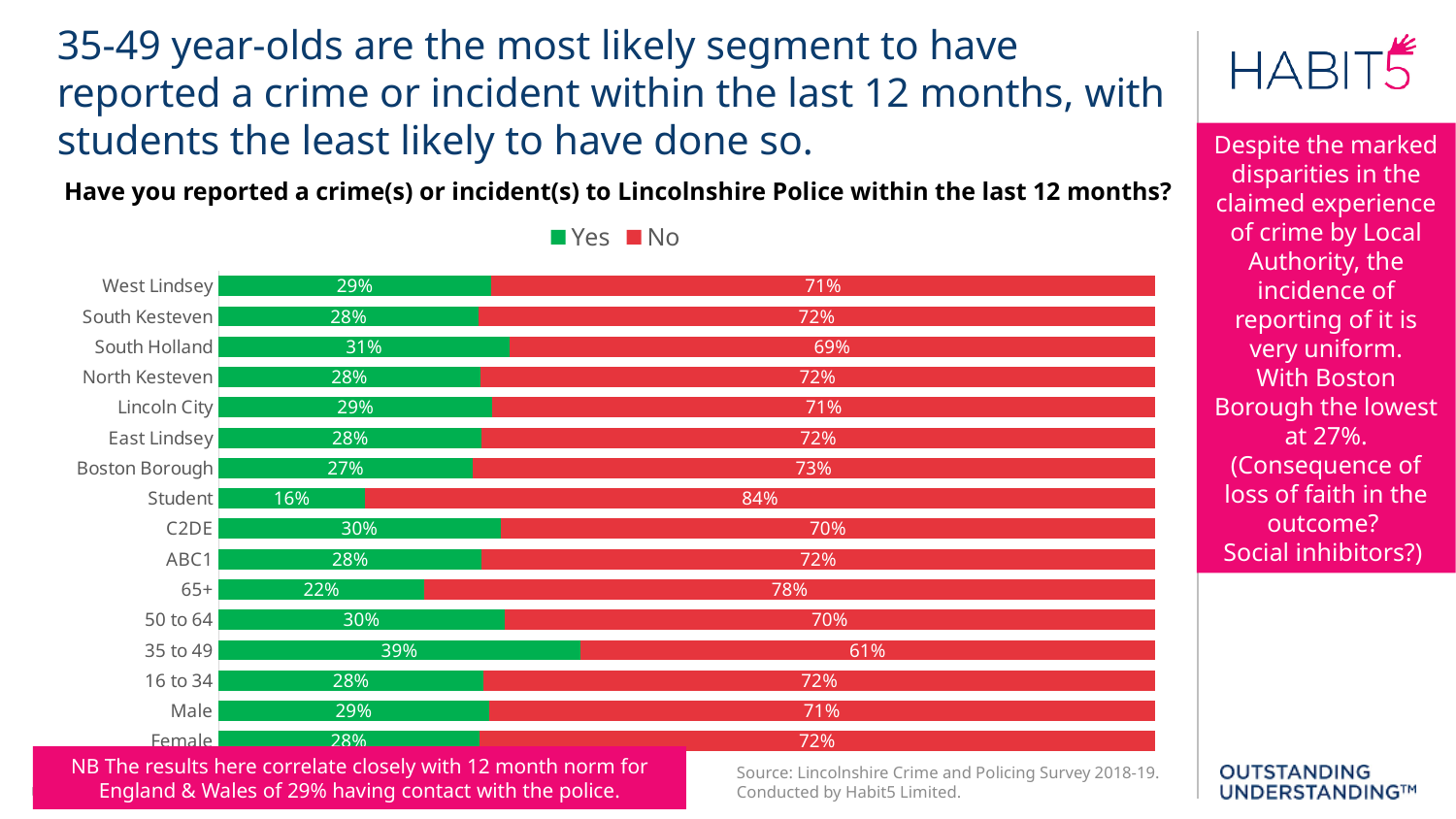
Which category has the lowest Yes value? Student Which has a higher Yes value, South Holland or 65+? South Holland How many categories are shown on the chart? 16 How many series does the legend list? 2 What is the No value for the 65+ group? 78% Which category has the highest Yes value? 35 to 49 What is the difference between the Yes values for 35 to 49 and Student? 23% What is the Yes value for Boston Borough? 27% What colour represents the No series? Red What percentage of Students answered No? 84% What kind of chart is shown on the slide? Stacked bar chart What percentage of 35 to 49 year-olds answered Yes? 39%